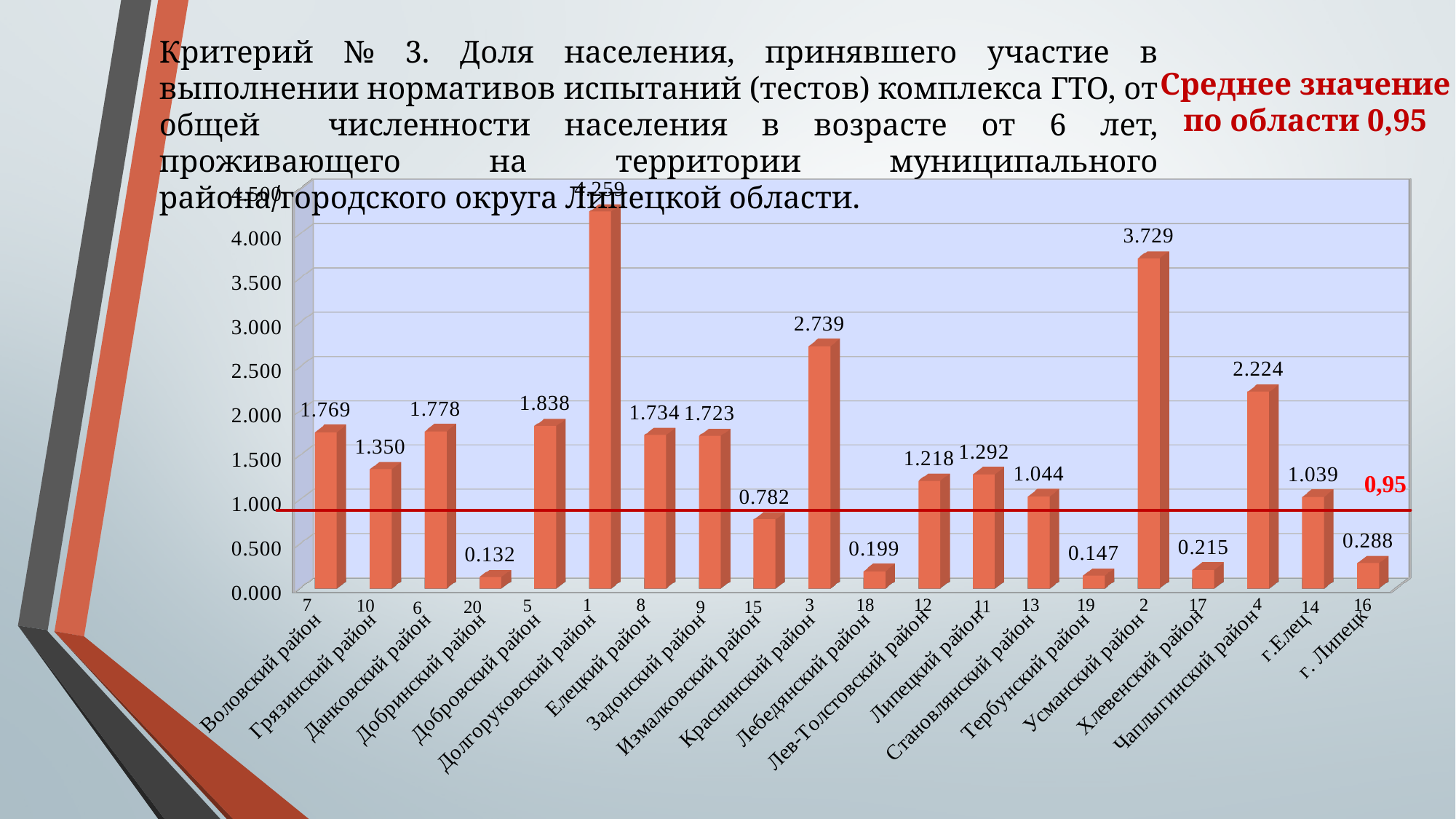
Which has a larger value, Данковский район or Грязинский район? Данковский район What value is shown for г. Липецк? 0.288 How many districts (categories) are shown on the chart? 20 Is the value for Измалковский район greater or less than 1.000? less What value is shown for Краснинский район? 2.739 What is the difference between the values for Усманский район and Краснинский район? 0.990 Which district has the highest bar on the chart? Долгоруковский район What value is shown for Чаплыгинский район? 2.224 Which district has the lowest value on the chart? Добринский район What kind of chart is shown on the slide? bar chart What value is shown for Усманский район? 3.729 What value does the red horizontal line on the chart mark? 0,95